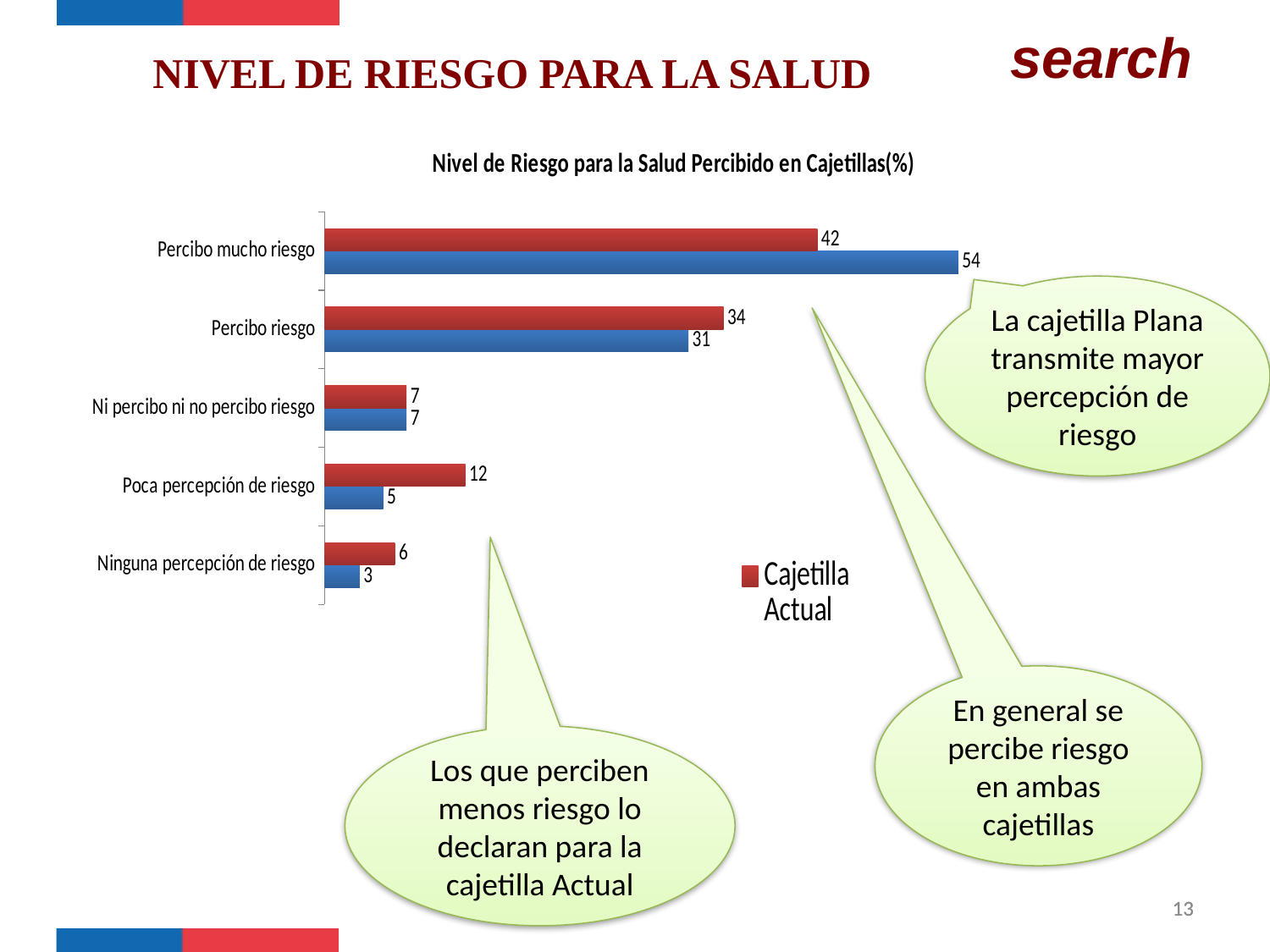
What is the value of the blue bar for 'Percibo mucho riesgo'? 54 Which category has the lowest value for the blue series? Ninguna percepción de riesgo What is the value for Cajetilla Actual in the category 'Percibo mucho riesgo'? 42 What is the value of the blue bar for 'Ninguna percepción de riesgo'? 3 Which series is shown in red according to the legend? Cajetilla Actual What type of chart is shown on the slide? Bar chart For 'Percibo riesgo', which is larger: the Cajetilla Actual value or the blue bar value? Cajetilla Actual What is the title of the chart? Nivel de Riesgo para la Salud Percibido en Cajetillas(%) What is the difference between the blue bar and the Cajetilla Actual bar for 'Percibo mucho riesgo'? 12 What is the value for Cajetilla Actual in the category 'Poca percepción de riesgo'? 12 How many categories are shown on the chart? 5 Which category has the highest value for Cajetilla Actual? Percibo mucho riesgo